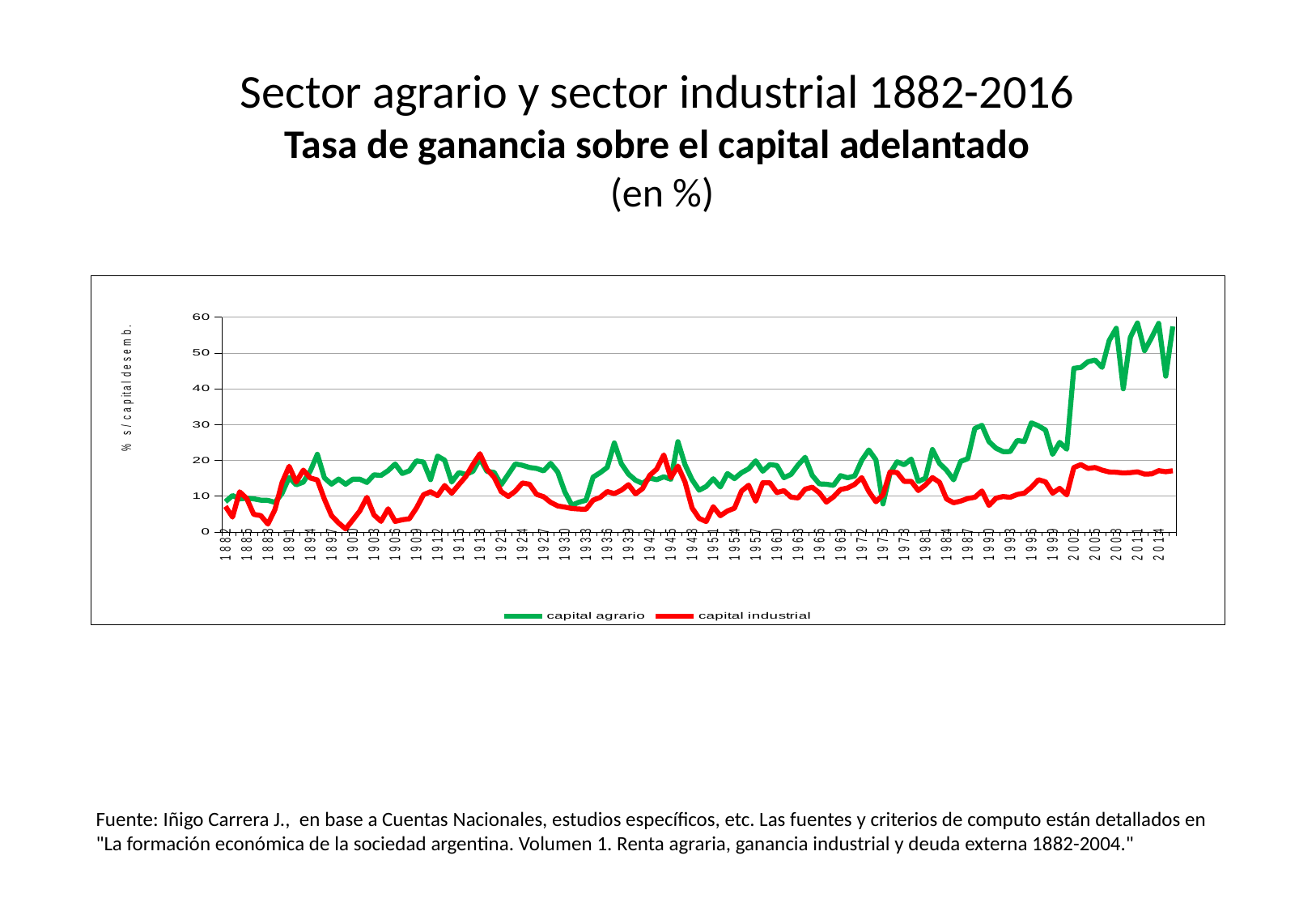
Is the value for capital industrial in 1951 greater or less than 10? less In 2014, which series has the higher value, capital agrario or capital industrial? capital agrario What kind of chart is shown on the slide? line chart Is the value for capital industrial in 1900 greater or less than 10? less Is the value for capital industrial in 2014 greater or less than 20? less Which series reaches the highest value anywhere on the chart? capital agrario What are the two series named in the chart legend? capital agrario and capital industrial How many series does the chart legend list? 2 Which colour is used for the capital industrial series? red Does the capital agrario series rise or fall between 1999 and 2005? rise